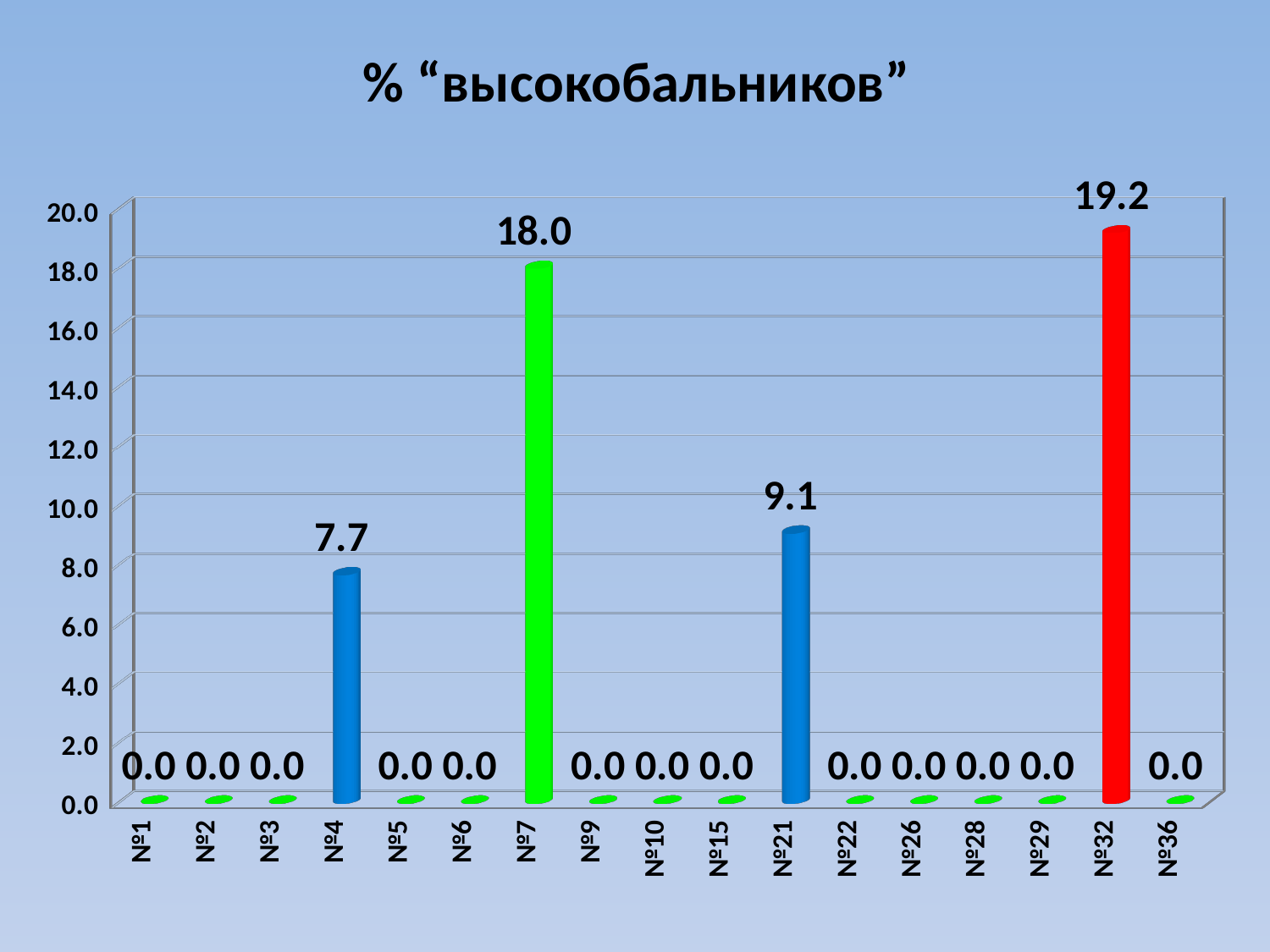
What is the value for №7? 18.0 What is the difference between the values for №21 and №4? 1.4 Is the value for №21 greater or less than 10.0? less Which category has the highest value? №32 What is the value for №4? 7.7 What is the value for №21? 9.1 How many categories are shown on the x axis? 17 What is the value for №32? 19.2 What colour is the bar for №32? red What is the difference between the values for №32 and №7? 1.2 Which is larger, the value for №7 or the value for №32? №32 What kind of chart is shown on the slide? bar chart